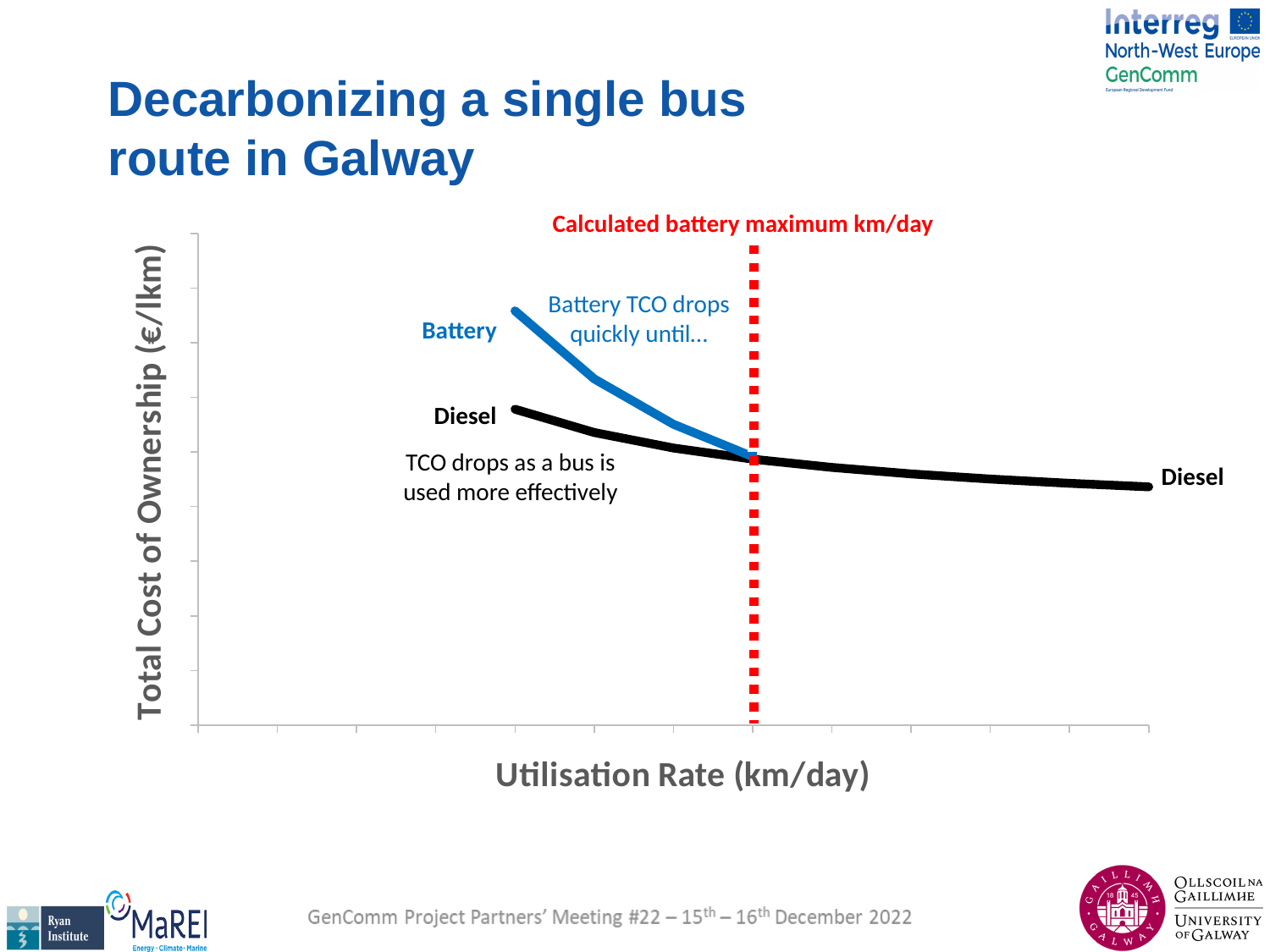
Does the Battery line rise or fall as the utilisation rate increases? fall What kind of chart is shown on the slide? line chart At the left end of the plotted lines, which has the higher total cost of ownership, Battery or Diesel? Battery What does the red dotted vertical line on the chart represent? Calculated battery maximum km/day What is the title of the x axis of the chart? Utilisation Rate (km/day) Which series falls more steeply as utilisation rate increases, Battery or Diesel? Battery Does the Diesel line rise or fall as the utilisation rate increases? fall What is the title of the y axis of the chart? Total Cost of Ownership (€/lkm) How many lines (series) are plotted on the chart? 2 Which line extends further to the right along the x axis, Battery or Diesel? Diesel